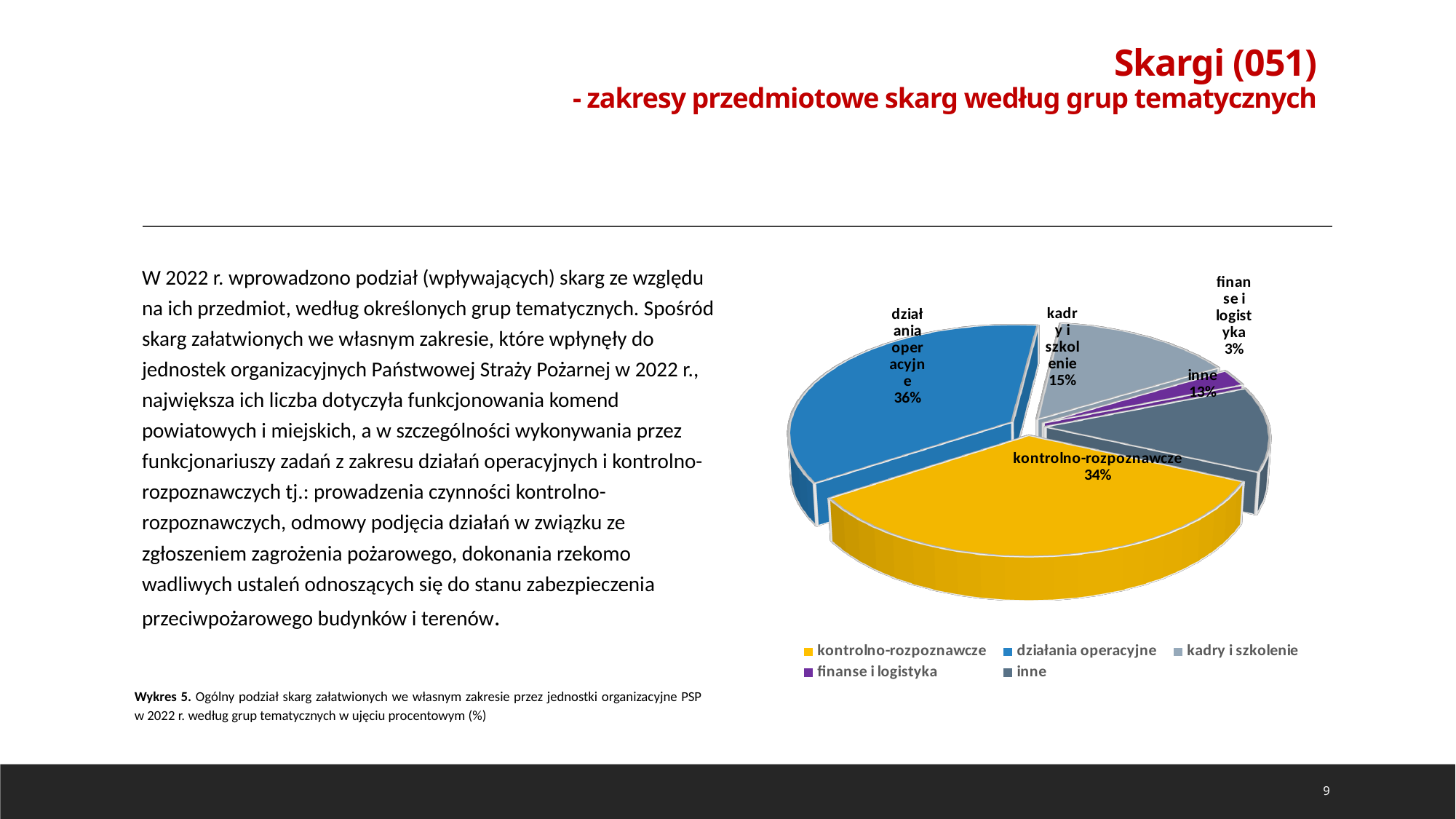
What share of the pie does "działania operacyjne" have? 36% How many categories does the legend list? 5 What share of the pie does "inne" have? 13% What share of the pie does "finanse i logistyka" have? 3% What kind of chart is shown on the slide? pie chart Which category has the smallest share of the pie? finanse i logistyka What colour is the "kontrolno-rozpoznawcze" slice? yellow What is the difference in percentage points between "działania operacyjne" and "kontrolno-rozpoznawcze"? 2 Which is larger, the share for "kadry i szkolenie" or the share for "inne"? kadry i szkolenie Which category has the largest share of the pie? działania operacyjne